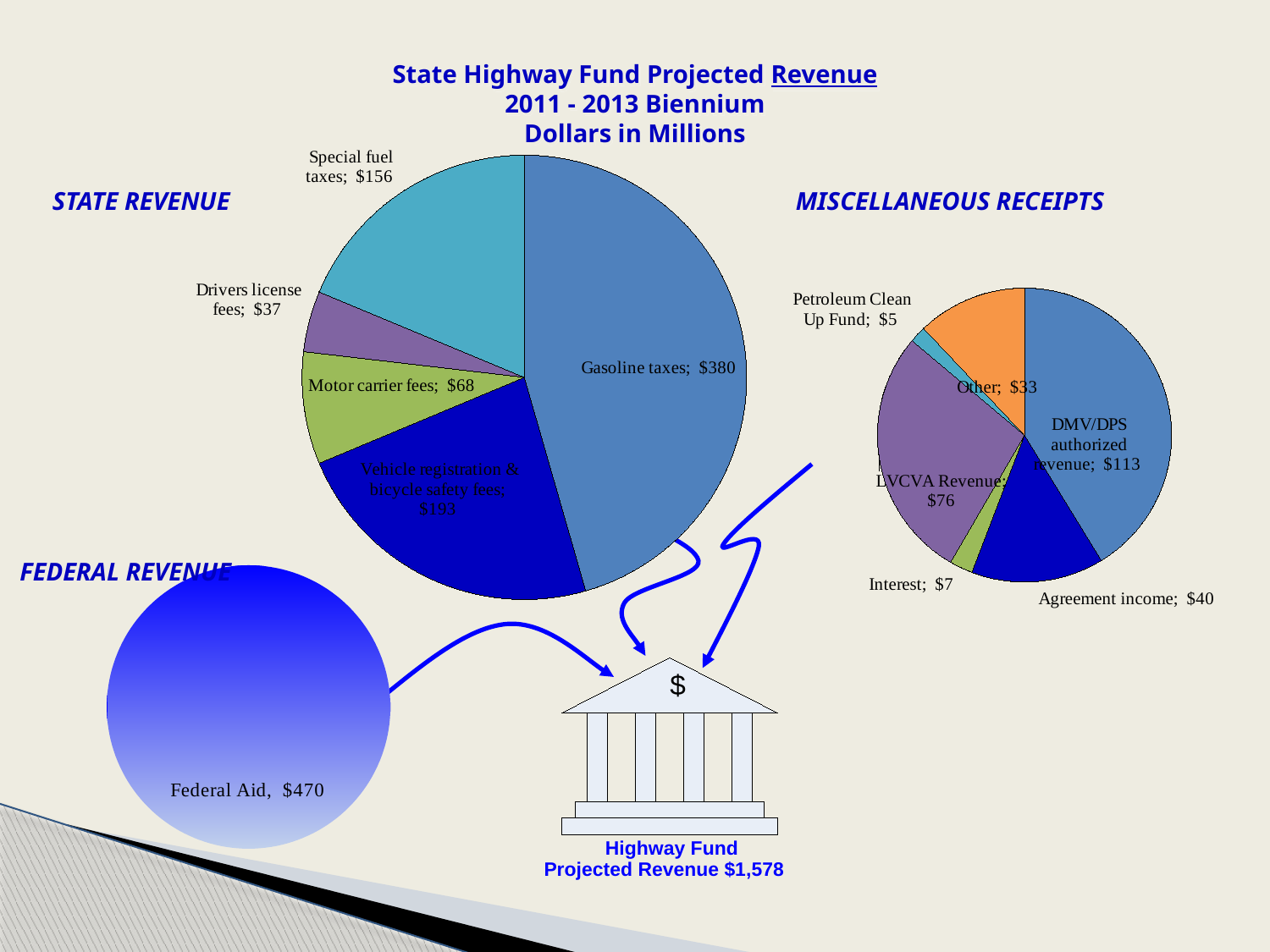
What is the total Highway Fund Projected Revenue shown on the slide? $1,578 In the State Revenue pie chart, what is the difference between Gasoline taxes and Special fuel taxes? $224 In the State Revenue pie chart, what is the value for Vehicle registration & bicycle safety fees? $193 In the State Revenue pie chart, which category has the largest value? Gasoline taxes What type of chart is used for Miscellaneous Receipts? Pie chart In the Miscellaneous Receipts pie chart, what is the value for LVCVA Revenue? $76 In the State Revenue pie chart, which category has the smallest value? Drivers license fees How many slices does the State Revenue pie chart have? 5 How many slices does the Miscellaneous Receipts pie chart have? 6 In the State Revenue pie chart, what is the value for Gasoline taxes? $380 In the Miscellaneous Receipts pie chart, which is larger: DMV/DPS authorized revenue or LVCVA Revenue? DMV/DPS authorized revenue In the Miscellaneous Receipts pie chart, which category has the smallest value? Petroleum Clean Up Fund